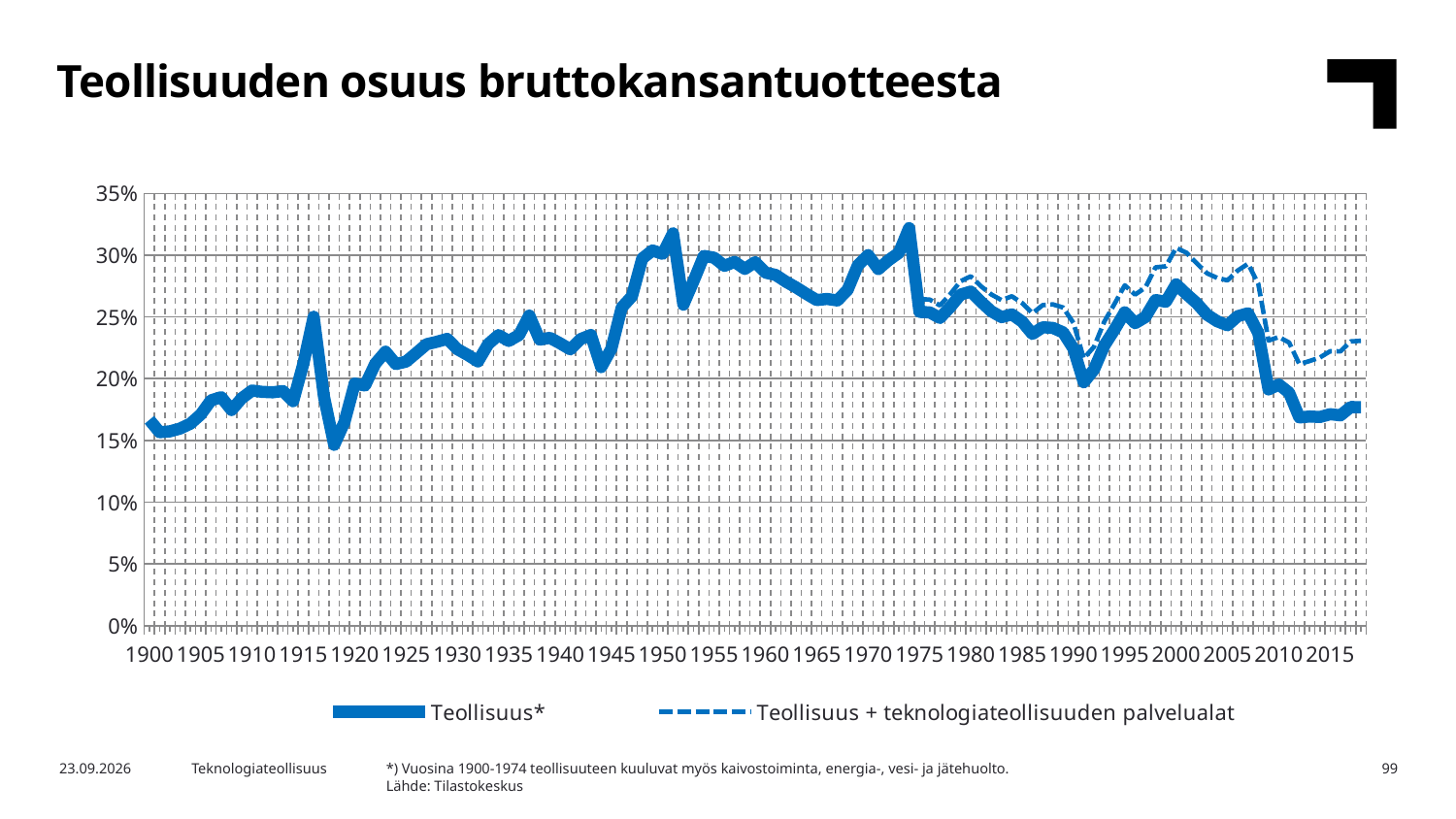
Is the value for Teollisuus* in 2015 greater or less than 20%? less Is the value for Teollisuus + teknologiateollisuuden palvelualat in 2010 greater or less than 25%? less Does the Teollisuus* series rise or fall between 2005 and 2015? Fall Does the Teollisuus* series rise or fall between 1900 and 1915? Rise Which series is drawn with a dashed line? Teollisuus + teknologiateollisuuden palvelualat How many series does the legend list? 2 Is the value for Teollisuus* in 1900 greater or less than 20%? less What is the title of the chart? Teollisuuden osuus bruttokansantuotteesta In 2015, which series has the higher value, Teollisuus* or Teollisuus + teknologiateollisuuden palvelualat? Teollisuus + teknologiateollisuuden palvelualat What kind of chart is shown on the slide? Line chart